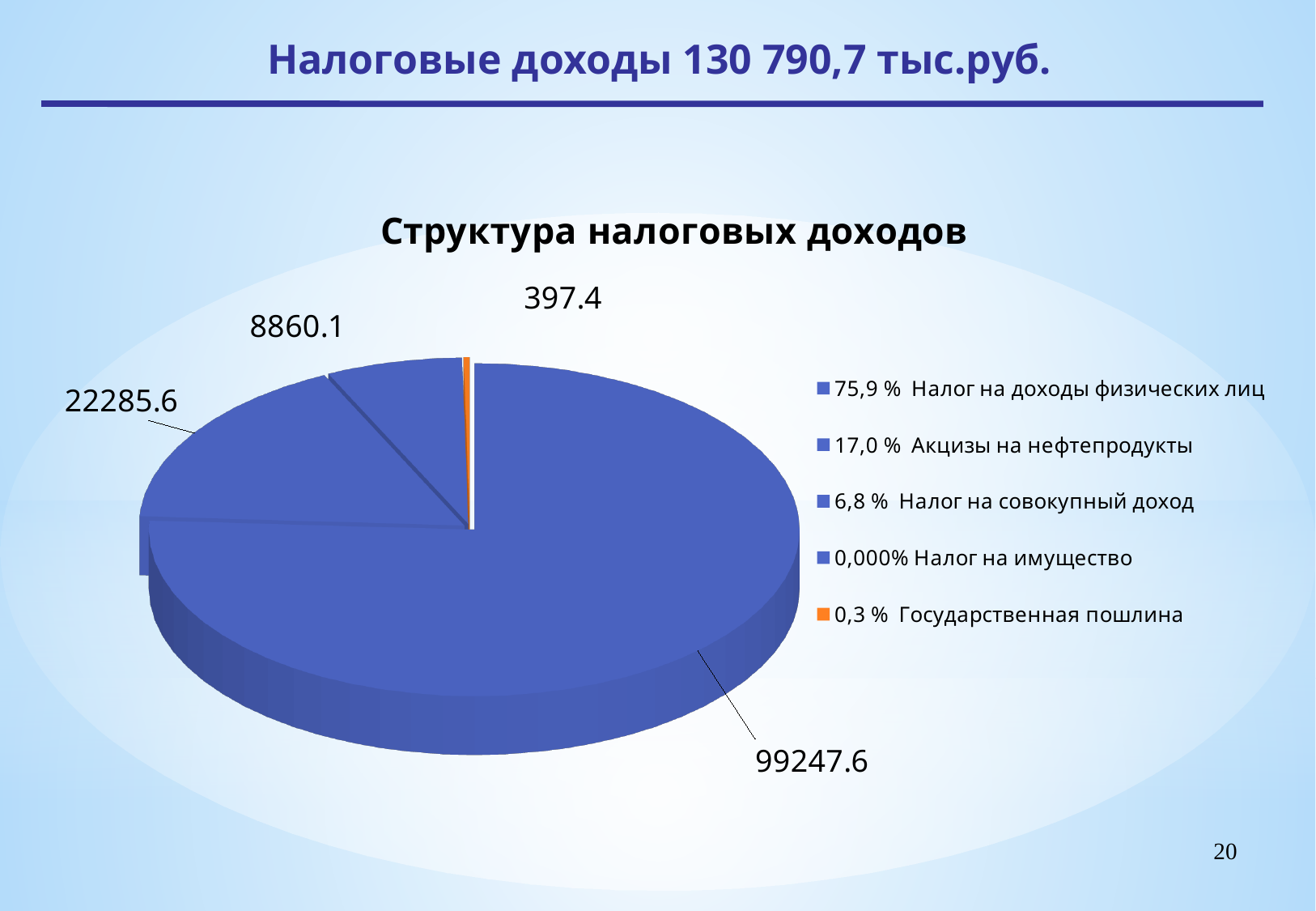
What is the title of the chart? Структура налоговых доходов What is the difference between the slice valued 22285.6 and the slice valued 8860.1? 13425.5 Which slice is larger: the one valued 8860.1 or the one valued 397.4? 8860.1 Which category has the largest share of the pie? Налог на доходы физических лиц What is the value of the largest slice of the pie? 99247.6 How many entries does the chart legend list? 5 What share of the pie does Налог на совокупный доход have according to the legend? 6,8 % What share of the pie does Акцизы на нефтепродукты have according to the legend? 17,0 % What is the value of the slice labelled for Акцизы на нефтепродукты (the second-largest slice)? 22285.6 What kind of chart is shown on the slide? pie chart What is the value of the smallest visible slice (Государственная пошлина)? 397.4 What share of the pie does Государственная пошлина have according to the legend? 0,3 %